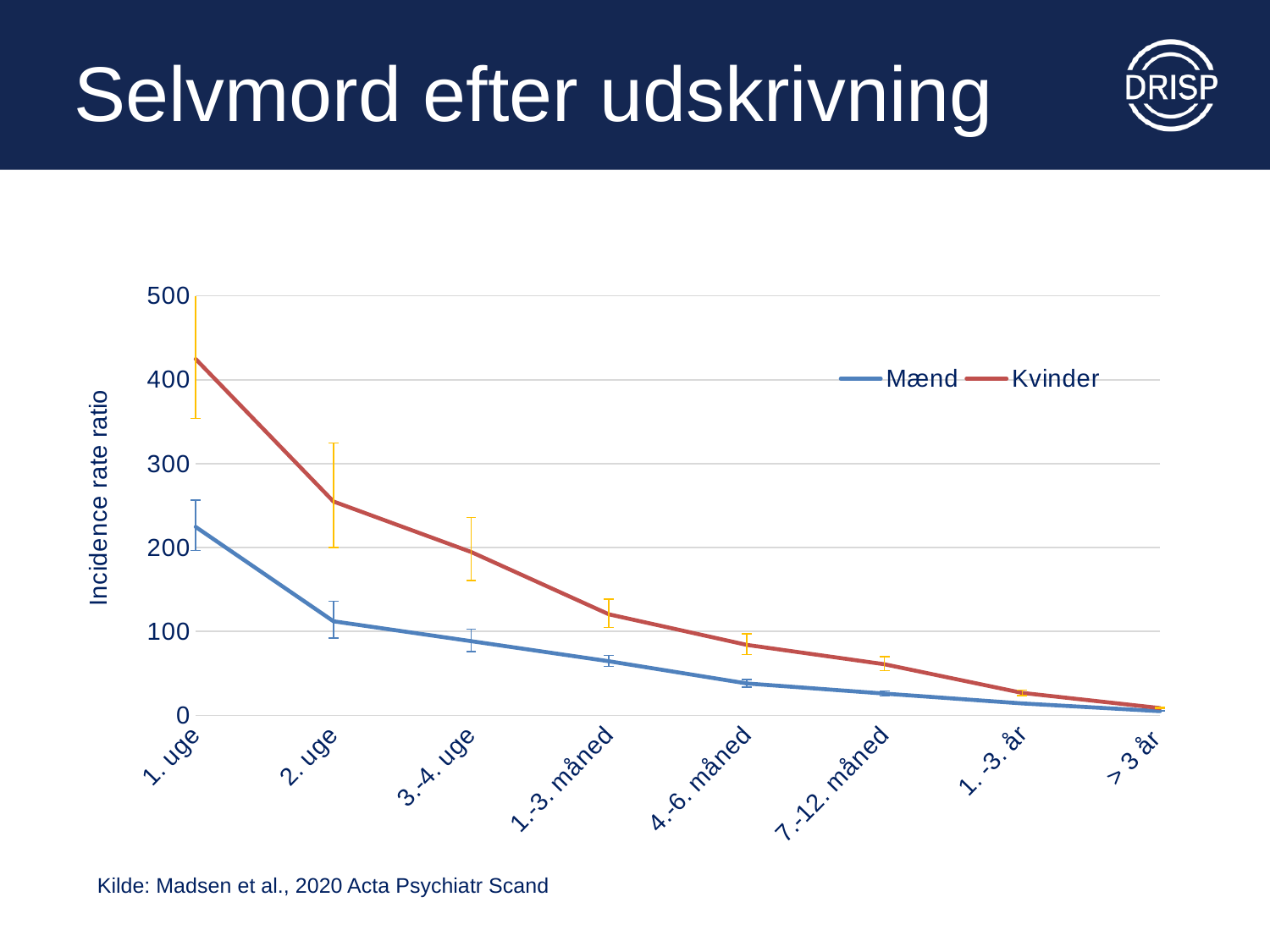
At which category is the Kvinder series highest? 1. uge Is the value for Kvinder at 1. uge greater or less than 400? greater At 1. uge, which series has the larger value, Mænd or Kvinder? Kvinder Is the value for Mænd at 1. uge greater or less than 200? greater How many series does the legend list? 2 What kind of chart is shown on the slide? line chart Is the value for Mænd at 4.-6. måned greater or less than 100? less What is the label of the y axis? Incidence rate ratio At which category is the Mænd series lowest? > 3 år Which series is plotted in red? Kvinder How many categories are shown on the x axis? 8 Do the values for Kvinder rise or fall along the x axis? fall